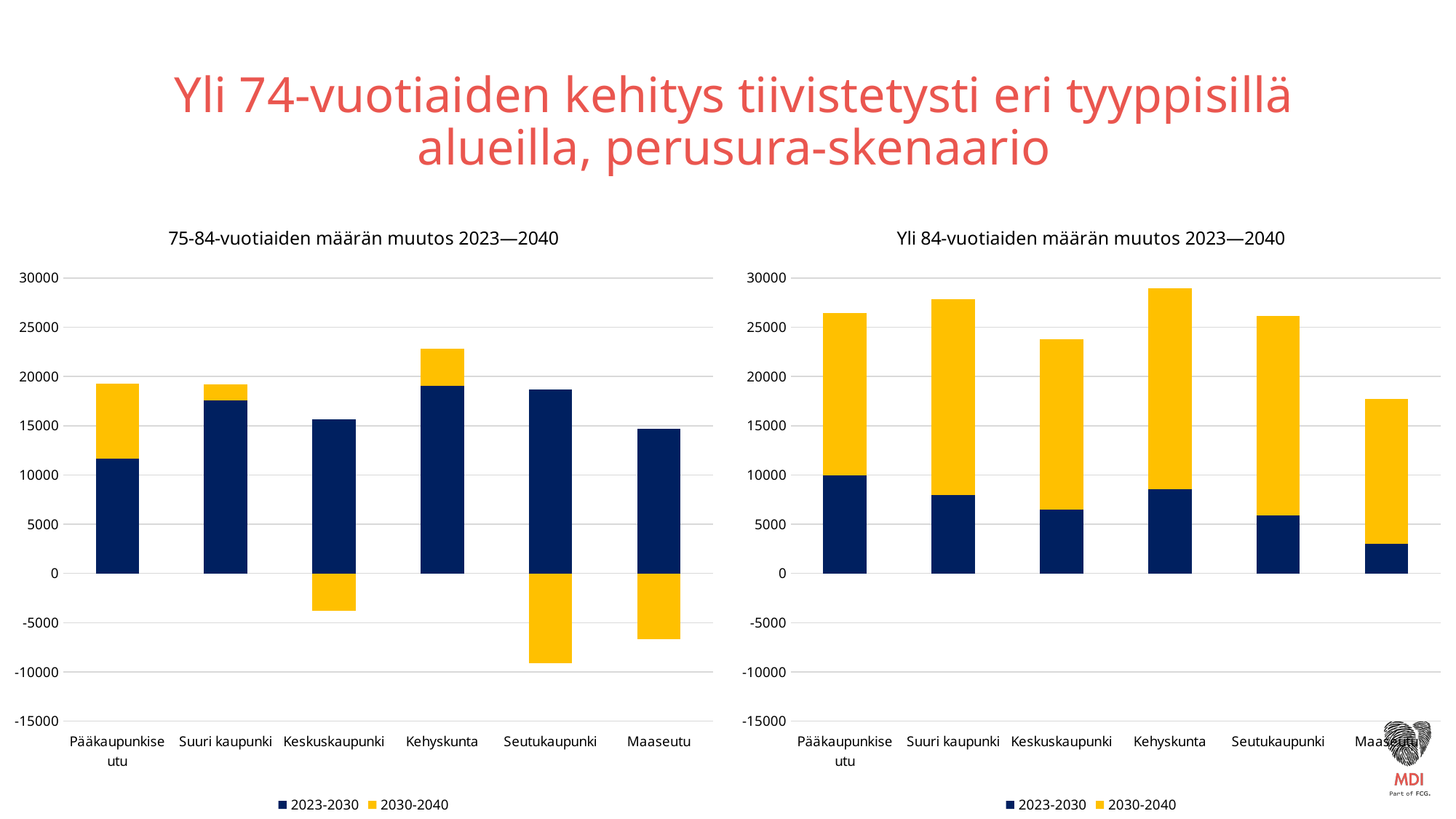
In the right chart 'Yli 84-vuotiaiden määrän muutos 2023—2040', which category has the highest 2023-2030 value? Pääkaupunkiseutu In the left chart '75-84-vuotiaiden määrän muutos 2023—2040', is the 2023-2030 value for Kehyskunta greater or less than 15000? greater In the left chart '75-84-vuotiaiden määrän muutos 2023—2040', is the 2030-2040 value for Seutukaupunki greater or less than -5000? less In the right chart 'Yli 84-vuotiaiden määrän muutos 2023—2040', which category has the lowest 2023-2030 value? Maaseutu In the right chart 'Yli 84-vuotiaiden määrän muutos 2023—2040', how many series does the legend list? 2 In the left chart '75-84-vuotiaiden määrän muutos 2023—2040', which has the larger 2030-2040 value, Pääkaupunkiseutu or Kehyskunta? Pääkaupunkiseutu In the left chart '75-84-vuotiaiden määrän muutos 2023—2040', which category has the lowest 2023-2030 value? Pääkaupunkiseutu What kind of chart is the left chart, '75-84-vuotiaiden määrän muutos 2023—2040'? Bar chart In the right chart 'Yli 84-vuotiaiden määrän muutos 2023—2040', is the 2023-2030 value for Maaseutu greater or less than 5000? less In the left chart '75-84-vuotiaiden määrän muutos 2023—2040', how many categories are shown on the x axis? 6 What are the two legend entries of the left chart '75-84-vuotiaiden määrän muutos 2023—2040'? 2023-2030 and 2030-2040